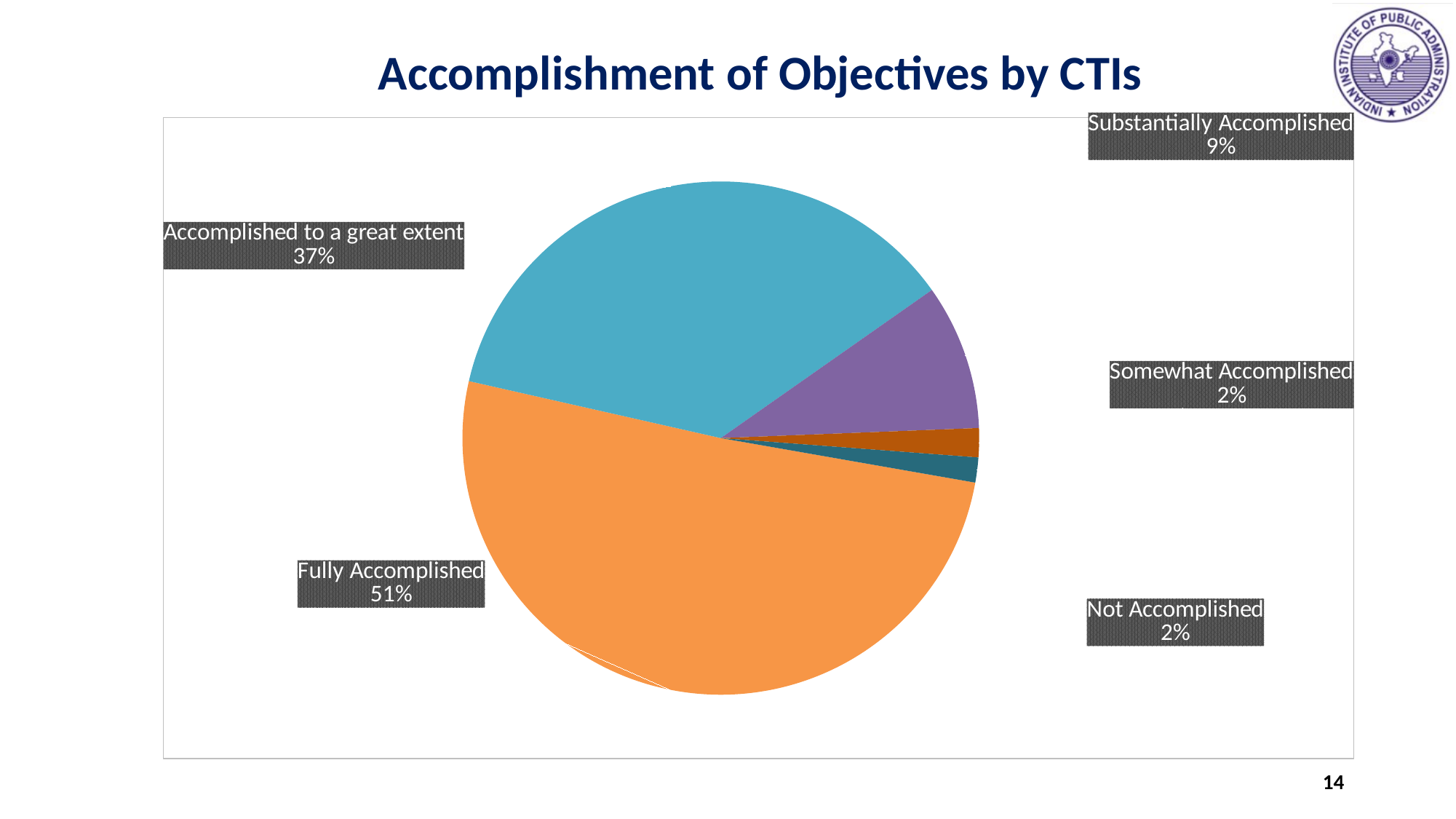
What share of the pie is Fully Accomplished? 51% What is the difference between the Fully Accomplished share and the Accomplished to a great extent share? 14% What share of the pie is Accomplished to a great extent? 37% Which category has the largest share of the pie? Fully Accomplished How many categories are shown in the pie chart? 5 What share of the pie is Substantially Accomplished? 9% Which is larger, the share for Accomplished to a great extent or the share for Substantially Accomplished? Accomplished to a great extent What is the title of the chart? Accomplishment of Objectives by CTIs What type of chart is shown on the slide? Pie chart What is the difference between the Substantially Accomplished share and the Somewhat Accomplished share? 7%